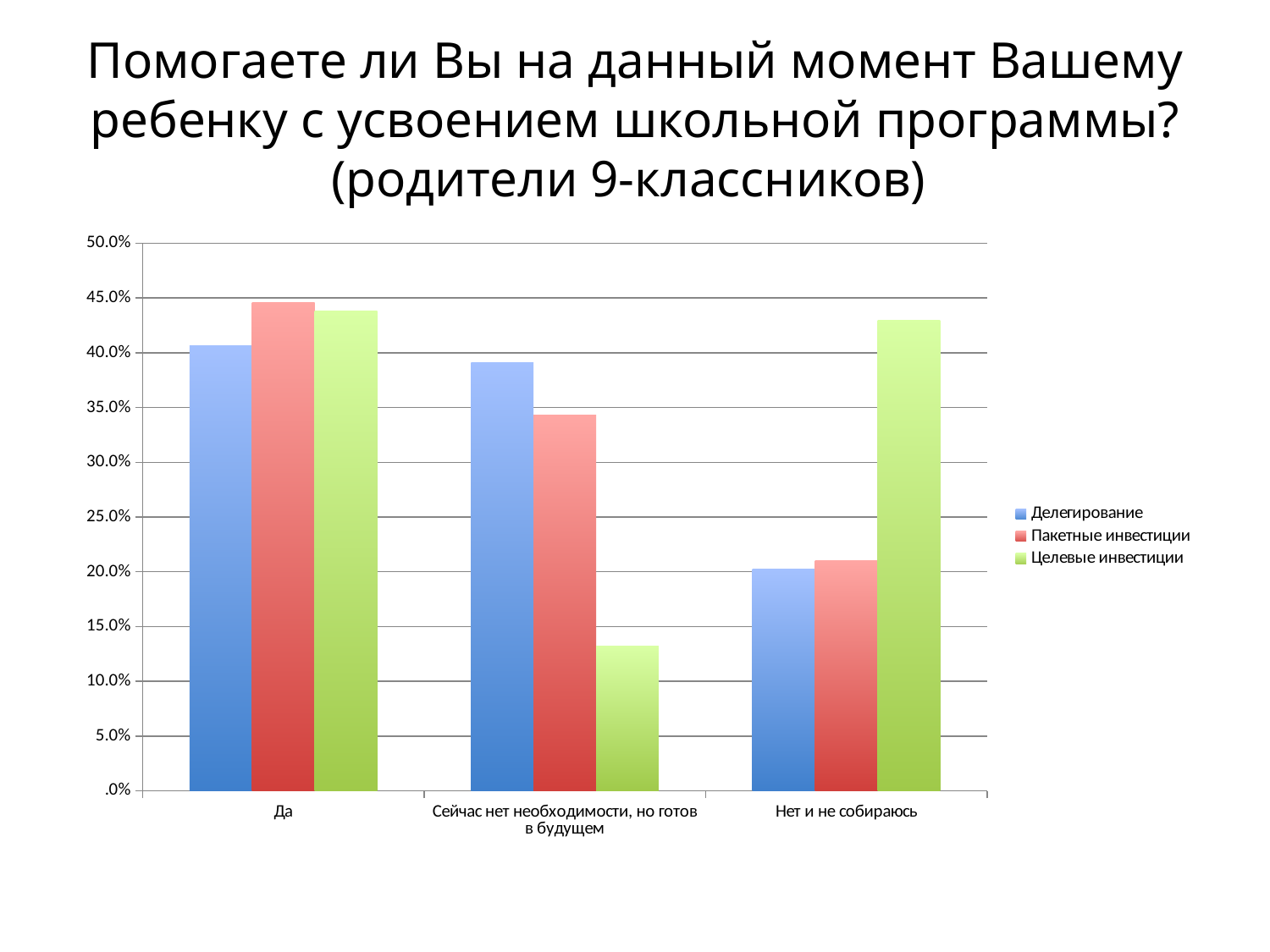
How many series does the legend list? 3 What kind of chart is shown on the slide? bar chart Is the value for Целевые инвестиции in the category "Нет и не собираюсь" greater or less than 40.0%? greater Is the value for Целевые инвестиции in the category "Сейчас нет необходимости, но готов в будущем" greater or less than 15.0%? less For the Целевые инвестиции series, which category has the lowest value? Сейчас нет необходимости, но готов в будущем In the category "Сейчас нет необходимости, но готов в будущем", which is larger: Делегирование or Целевые инвестиции? Делегирование Is the value for Делегирование in the category "Да" greater or less than 35.0%? greater In the category "Нет и не собираюсь", which is larger: Целевые инвестиции or Делегирование? Целевые инвестиции How many answer categories are shown on the x axis? 3 For the Пакетные инвестиции series, which category has the highest value? Да